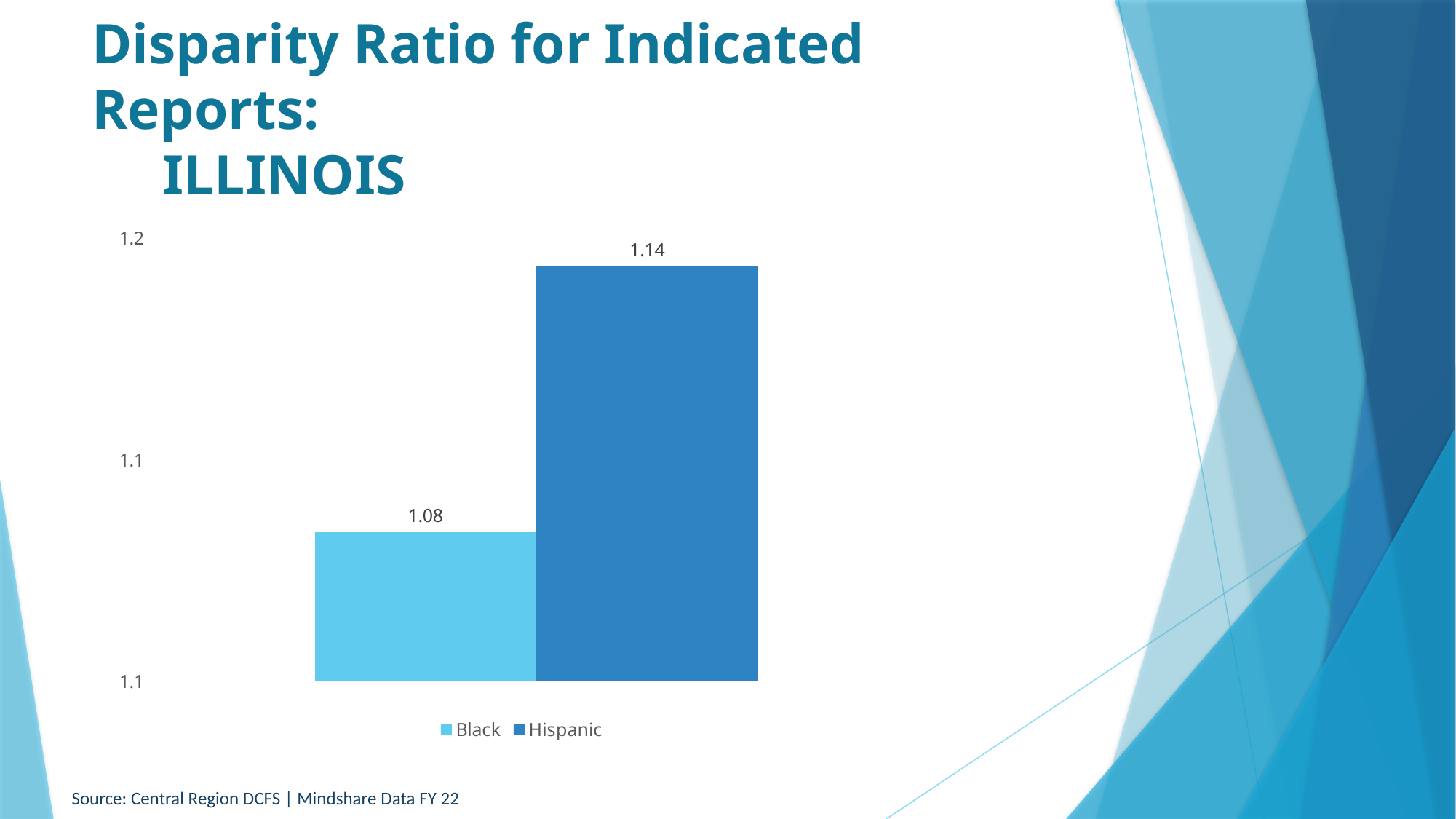
What is the difference between the Hispanic and Black disparity ratios? 0.06 Is the disparity ratio for Black larger or smaller than the ratio for Hispanic? smaller Is the value for Black greater or less than 1.1? less Which group has the lower disparity ratio? Black What is the title of the slide? Disparity Ratio for Indicated Reports: ILLINOIS What is the disparity ratio for Hispanic? 1.14 What kind of chart is shown on the slide? bar chart Which group has the higher disparity ratio? Hispanic Is the value for Hispanic greater or less than 1.1? greater How many bars are plotted in the chart? 2 What is the disparity ratio for Black? 1.08 How many entries does the legend list? 2